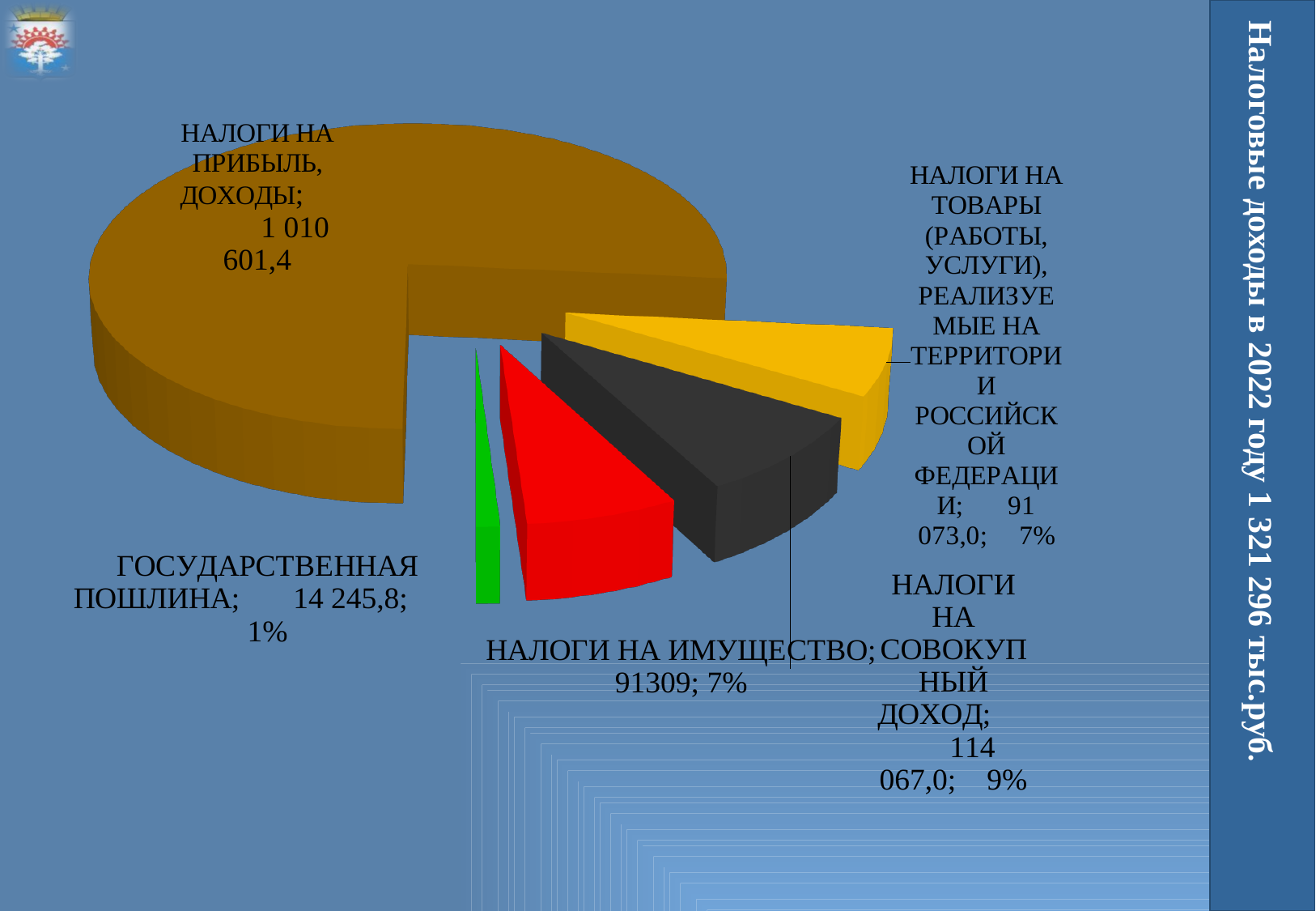
What is the value shown for ГОСУДАРСТВЕННАЯ ПОШЛИНА? 14 245,8 What share of the pie does ГОСУДАРСТВЕННАЯ ПОШЛИНА represent? 1% Which category has the smallest slice of the pie? ГОСУДАРСТВЕННАЯ ПОШЛИНА What kind of chart is shown on the slide? pie chart Which category has the largest slice of the pie? НАЛОГИ НА ПРИБЫЛЬ, ДОХОДЫ What is the value shown for НАЛОГИ НА ИМУЩЕСТВО? 91309 What is the value shown for НАЛОГИ НА СОВОКУПНЫЙ ДОХОД? 114 067,0 What share of the pie does НАЛОГИ НА СОВОКУПНЫЙ ДОХОД represent? 9% How many slices does the pie chart have? 5 What is the difference between the values for НАЛОГИ НА СОВОКУПНЫЙ ДОХОД and НАЛОГИ НА ТОВАРЫ (РАБОТЫ, УСЛУГИ), РЕАЛИЗУЕМЫЕ НА ТЕРРИТОРИИ РОССИЙСКОЙ ФЕДЕРАЦИИ? 22 994,0 What is the value shown for НАЛОГИ НА ПРИБЫЛЬ, ДОХОДЫ? 1 010 601,4 What total amount of tax revenue for 2022 is stated in the slide title? 1 321 296 тыс.руб.